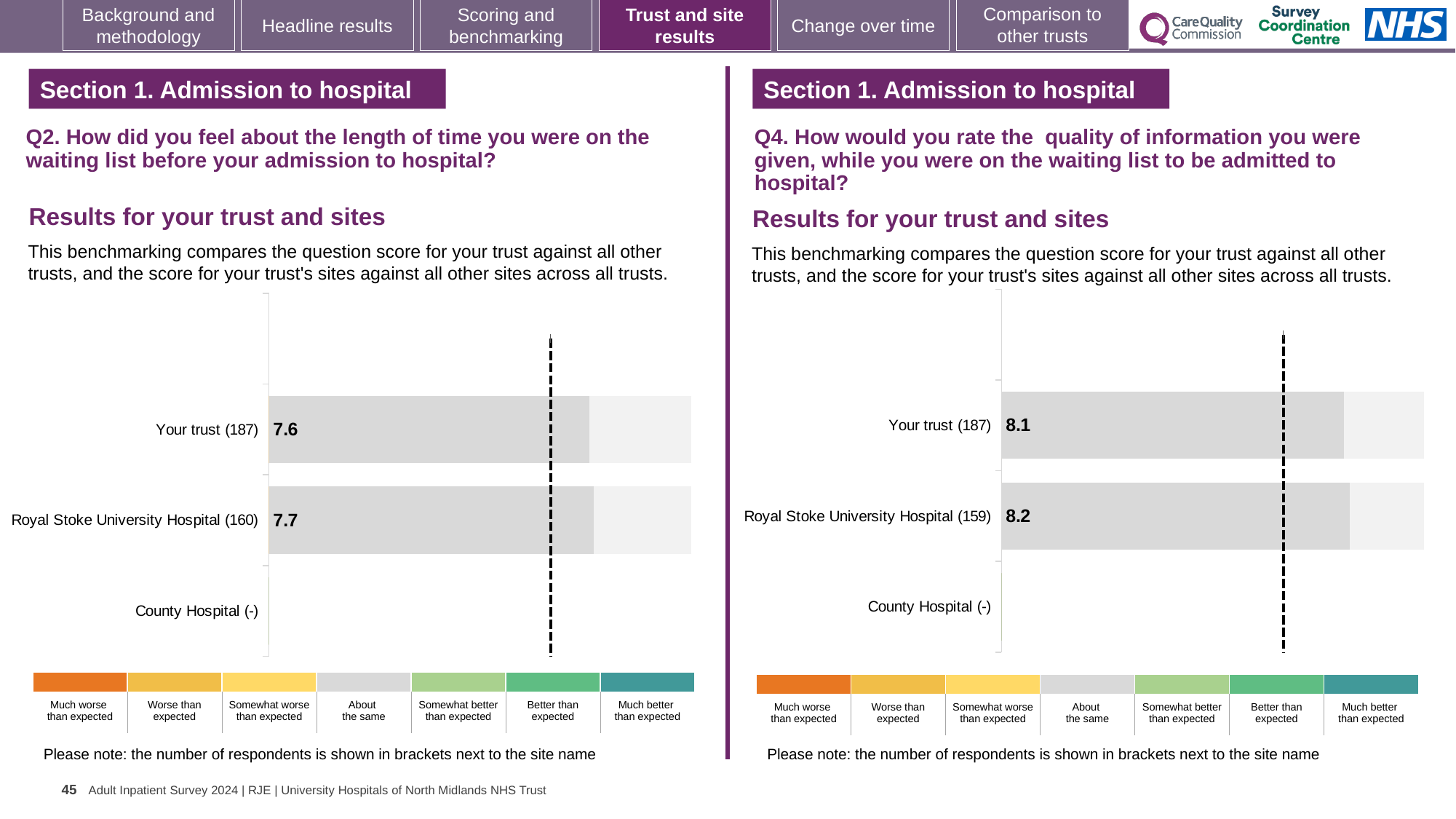
On the left chart (Q2), what is the score for Royal Stoke University Hospital? 7.7 On the right chart (Q4), what is the difference between the Royal Stoke University Hospital score and the Your trust score? 0.1 On the right chart (Q4), what is the score for Royal Stoke University Hospital? 8.2 How many categories are listed on the left chart (Q2)? 3 On the right chart (Q4), what is the score for Your trust? 8.1 On the left chart (Q2), what is the difference between the Royal Stoke University Hospital score and the Your trust score? 0.1 On the right chart (Q4), which has the higher score, Your trust or Royal Stoke University Hospital? Royal Stoke University Hospital On the right chart (Q4), how many respondents are shown in brackets for Royal Stoke University Hospital? 159 What kind of chart is used on the right (Q4)? Bar chart On the left chart (Q2), how many respondents are shown in brackets for Your trust? 187 On the left chart (Q2), what is the score for Your trust? 7.6 On the left chart (Q2), which has the lower score, Your trust or Royal Stoke University Hospital? Your trust